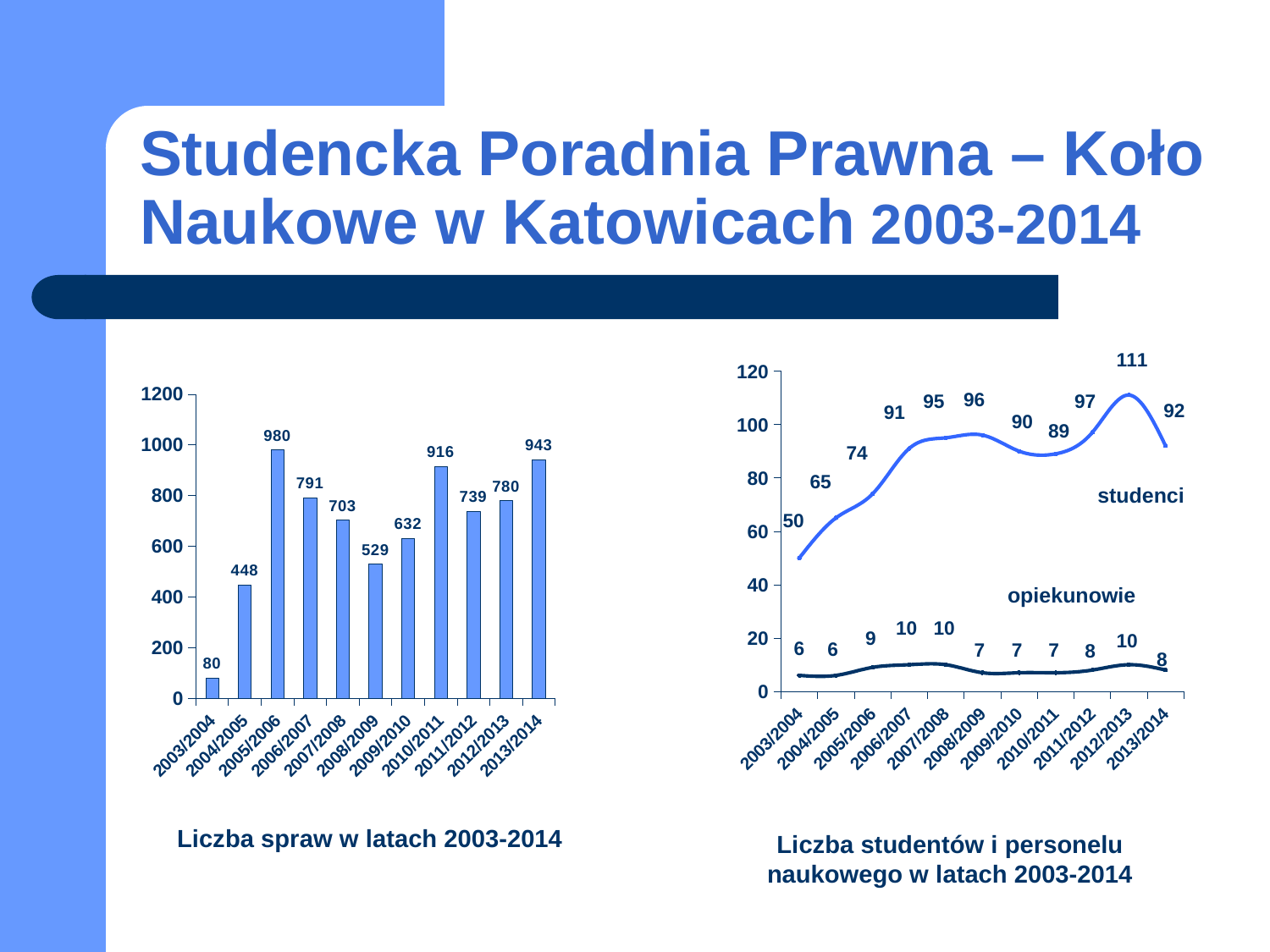
In the left chart (Liczba spraw w latach 2003-2014), is the value for 2010/2011 larger than the value for 2011/2012? Yes, 2010/2011 (916) is larger than 2011/2012 (739) In the left chart (Liczba spraw w latach 2003-2014), which year has the lowest value? 2003/2004 In the right chart (Liczba studentów i personelu naukowego), in which year is the studenci value lowest? 2003/2004 In the right chart (Liczba studentów i personelu naukowego), what is the difference between studenci and opiekunowie in 2013/2014? 84 In the right chart (Liczba studentów i personelu naukowego), what is the value for opiekunowie in 2003/2004? 6 In the left chart (Liczba spraw w latach 2003-2014), how many years are shown on the x axis? 11 What kind of chart is the right chart (Liczba studentów i personelu naukowego)? line chart In the left chart (Liczba spraw w latach 2003-2014), what is the difference between the values for 2013/2014 and 2012/2013? 163 In the right chart (Liczba studentów i personelu naukowego), what is the value for studenci in 2012/2013? 111 In the left chart (Liczba spraw w latach 2003-2014), what is the value for 2005/2006? 980 What kind of chart is the left chart (Liczba spraw w latach 2003-2014)? bar chart In the left chart (Liczba spraw w latach 2003-2014), which year has the highest value? 2005/2006